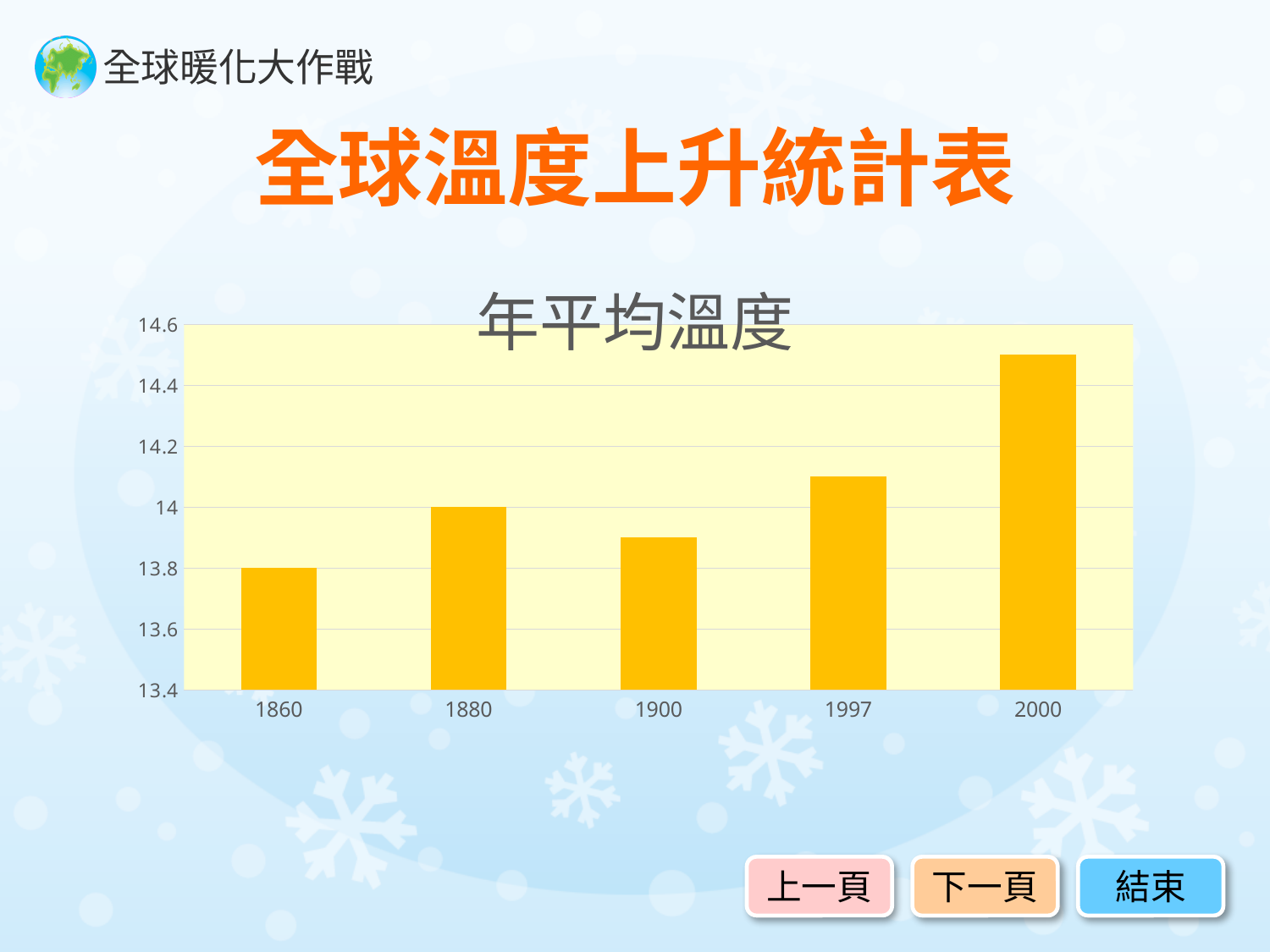
Is the value for 1997 greater or less than 14.2? less Which year has the lowest value? 1860 What is the title of the chart? 年平均溫度 Which year has the highest value? 2000 What is the value for 1880? 14 Which is larger, the value for 1880 or the value for 1900? 1880 Overall, do the values rise or fall from 1860 to 2000? rise What is the value for 1860? 13.8 How many years are shown on the x axis of the chart? 5 Is the value for 2000 greater or less than 14.4? greater What type of chart is shown on the slide? Bar chart What is the difference between the values for 1880 and 1860? 0.2